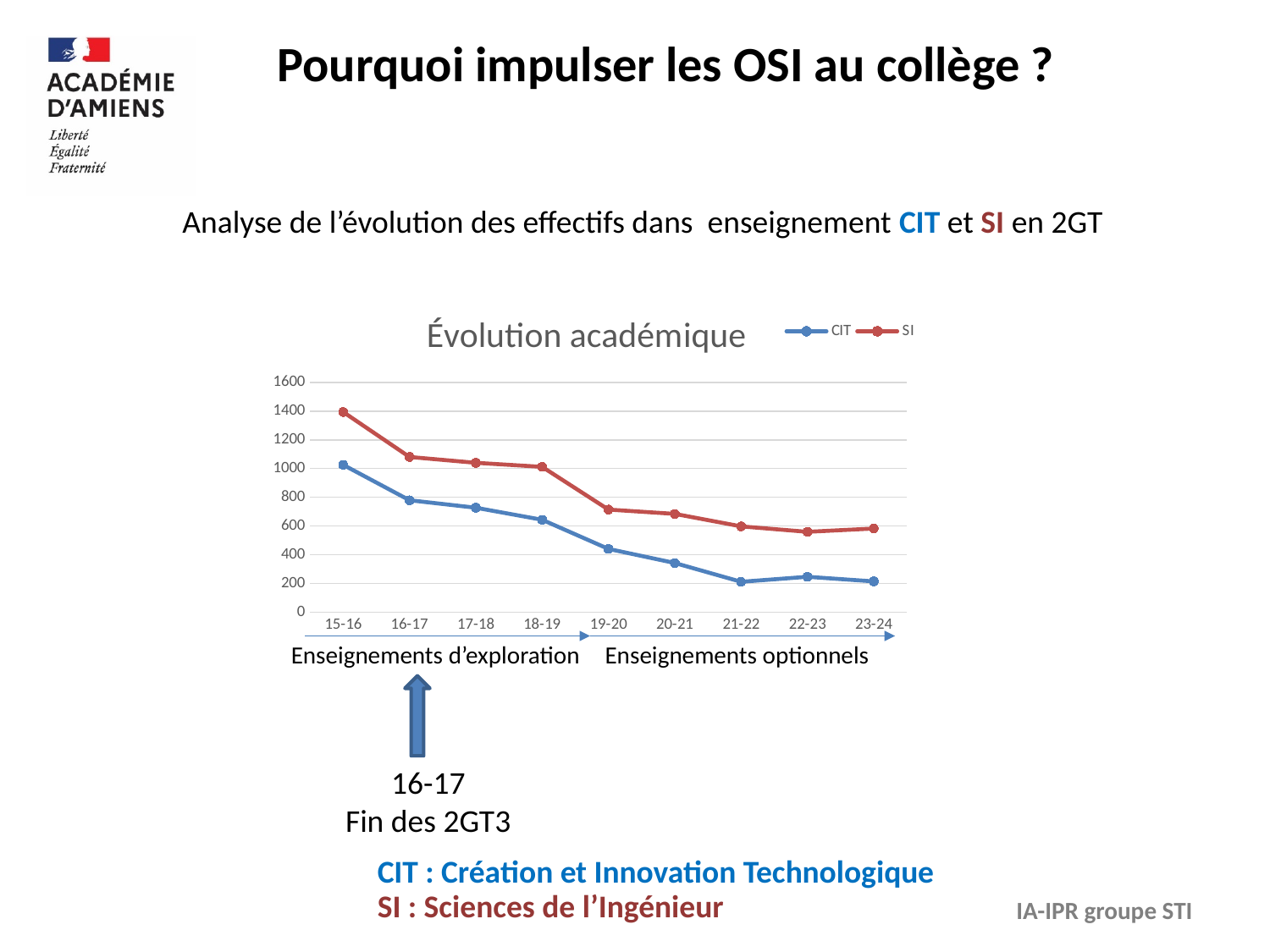
In which school year does the SI series reach its highest value? 15-16 In which school year does the CIT series reach its highest value? 15-16 What kind of chart is shown under the title "Évolution académique"? line chart How many school years are plotted along the x axis of the chart? 9 How many series does the legend of the "Évolution académique" chart list? 2 Is the value for SI in 15-16 greater or less than 1200? greater Is the value for SI in 19-20 greater or less than 600? greater Which series has the larger value in 18-19, CIT or SI? SI Which colour is used for the SI series in the chart? red Is the value for CIT in 21-22 greater or less than 400? less Do the CIT values generally rise or fall from 15-16 to 23-24? fall